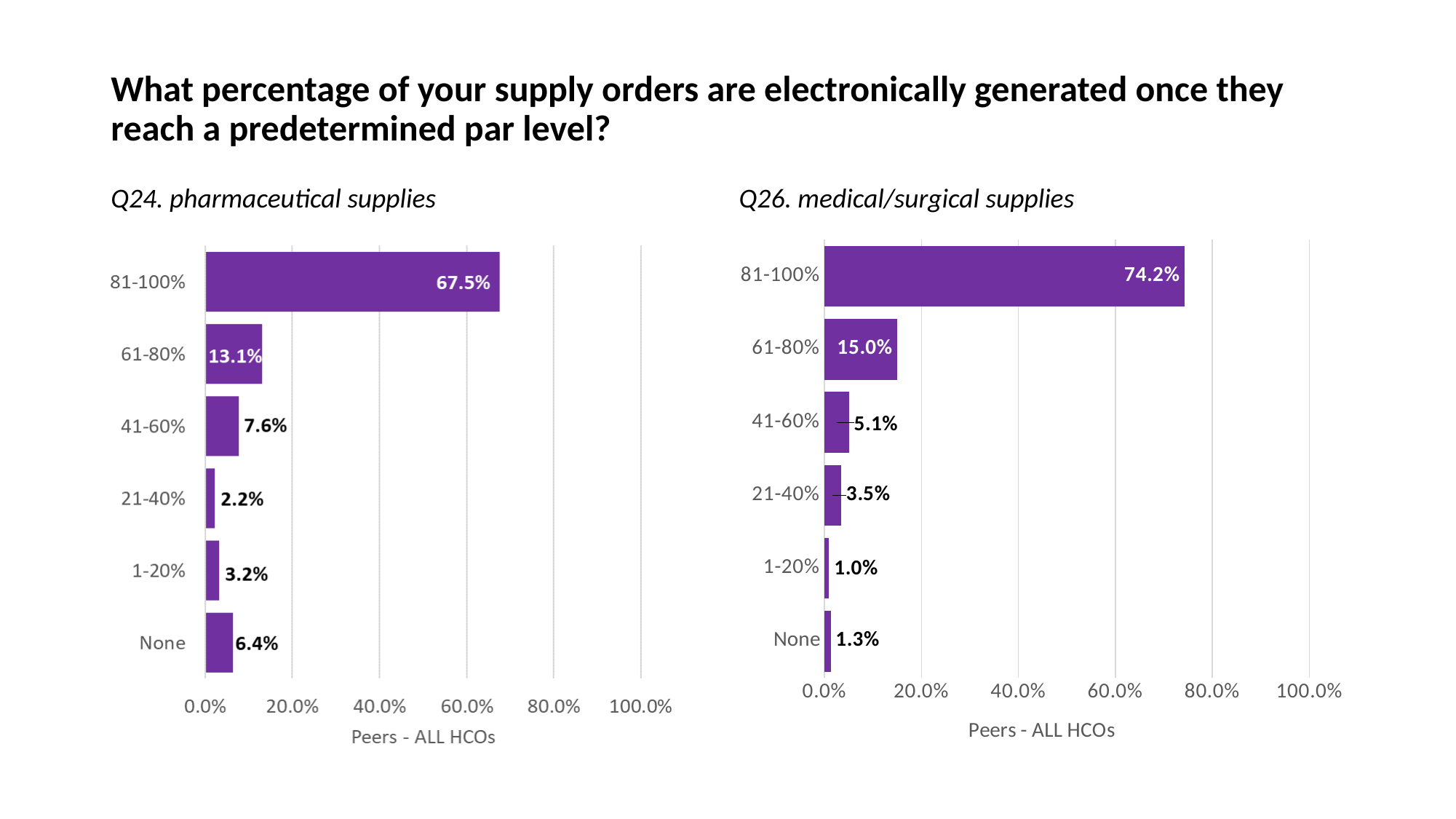
In the Q26 medical/surgical supplies chart, what is the difference between the values for 81-100% and 61-80%? 59.2% In the Q26 medical/surgical supplies chart, what is the value for 61-80%? 15.0% In the Q24 pharmaceutical supplies chart, which is larger, the value for 41-60% or the value for None? 41-60% In the Q24 pharmaceutical supplies chart, is the value for 81-100% greater or less than 60.0%? greater How many categories are shown in the Q26 medical/surgical supplies chart? 6 In the Q26 medical/surgical supplies chart, which category has the highest value? 81-100% In the Q24 pharmaceutical supplies chart, what is the value for None? 6.4% What kind of chart is the Q24 pharmaceutical supplies chart? bar chart What is the x-axis label on the Q26 medical/surgical supplies chart? Peers - ALL HCOs In the Q24 pharmaceutical supplies chart, which category has the lowest value? 21-40% In the Q24 pharmaceutical supplies chart, what is the value for 81-100%? 67.5% In the Q26 medical/surgical supplies chart, which category has the lowest value? 1-20%